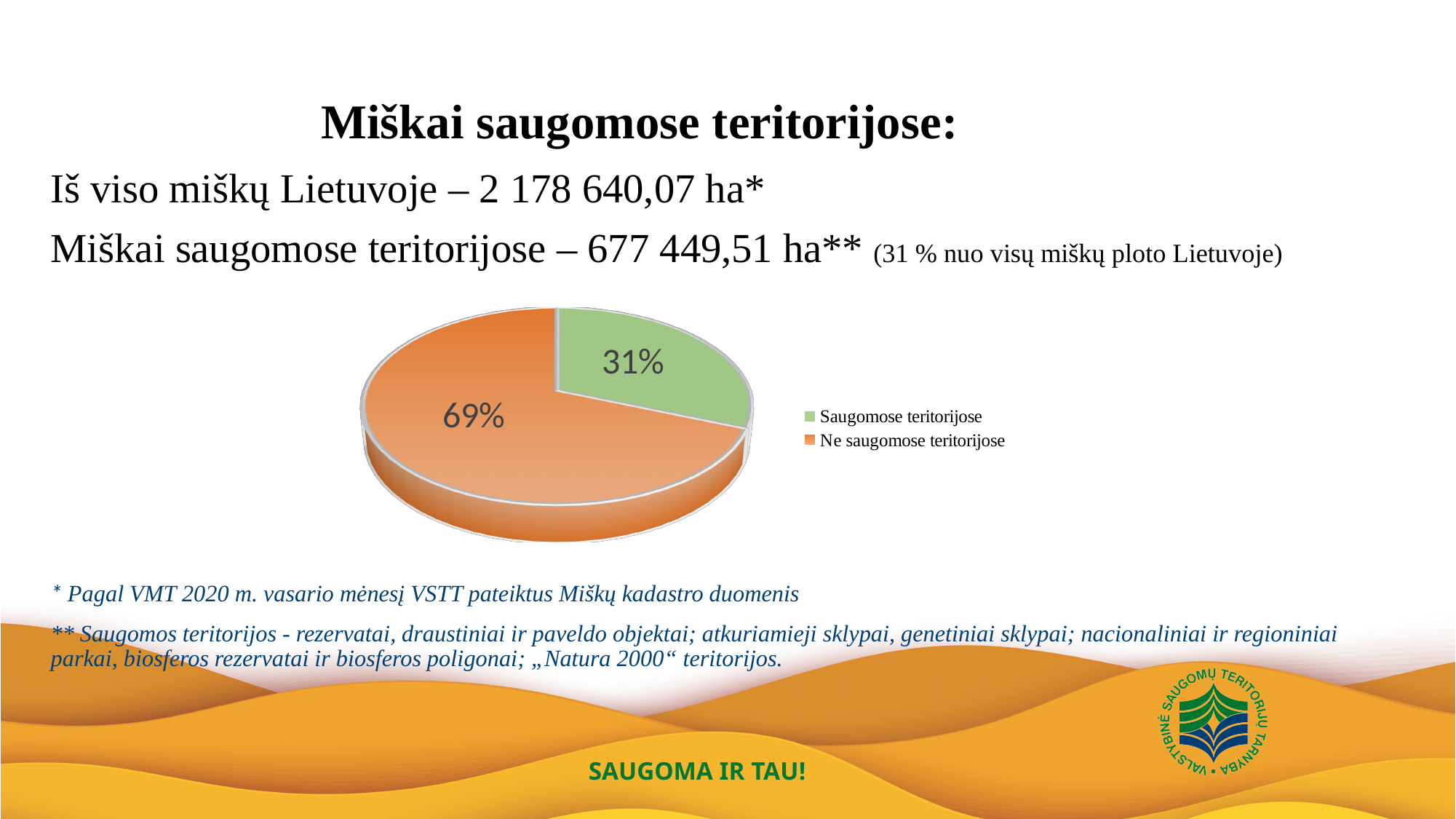
How many entries does the legend list? 2 Which slice of the pie is the smallest? Saugomose teritorijose What is the difference in percentage points between the "Ne saugomose teritorijose" slice and the "Saugomose teritorijose" slice? 38 What colour is the "Saugomose teritorijose" slice? green What share of the pie does "Ne saugomose teritorijose" represent? 69% What colour is the "Ne saugomose teritorijose" slice? orange What type of chart is shown on the slide? pie chart How many slices does the pie chart have? 2 What is the total of the two percentages shown on the pie chart? 100% Which slice of the pie is the largest? Ne saugomose teritorijose What share of the pie does "Saugomose teritorijose" represent? 31% Which is larger: the "Saugomose teritorijose" slice or the "Ne saugomose teritorijose" slice? Ne saugomose teritorijose